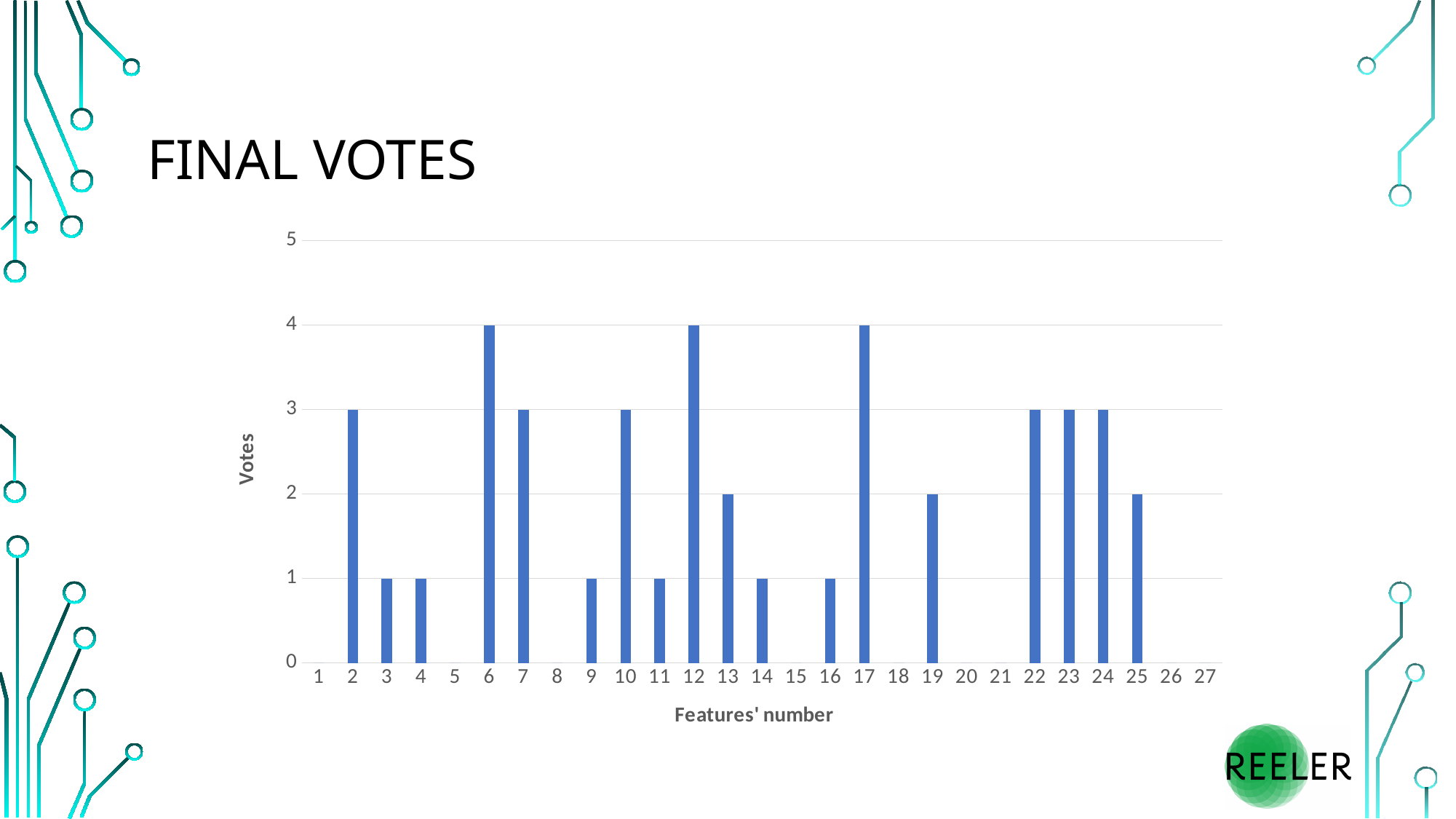
What is the highest number of votes any feature received? 4 How many votes did feature number 6 receive? 4 How many votes did feature number 22 receive? 3 Which received more votes, feature 17 or feature 19? feature 17 How many votes did feature number 3 receive? 1 How many votes did feature number 13 receive? 2 What is the difference in votes between feature 12 and feature 25? 2 Is the value for feature 7 greater or less than 2? greater What is the label of the x axis? Features' number What is the title of the slide? FINAL VOTES What kind of chart is shown on the slide? bar chart How many feature numbers are shown on the x axis? 27